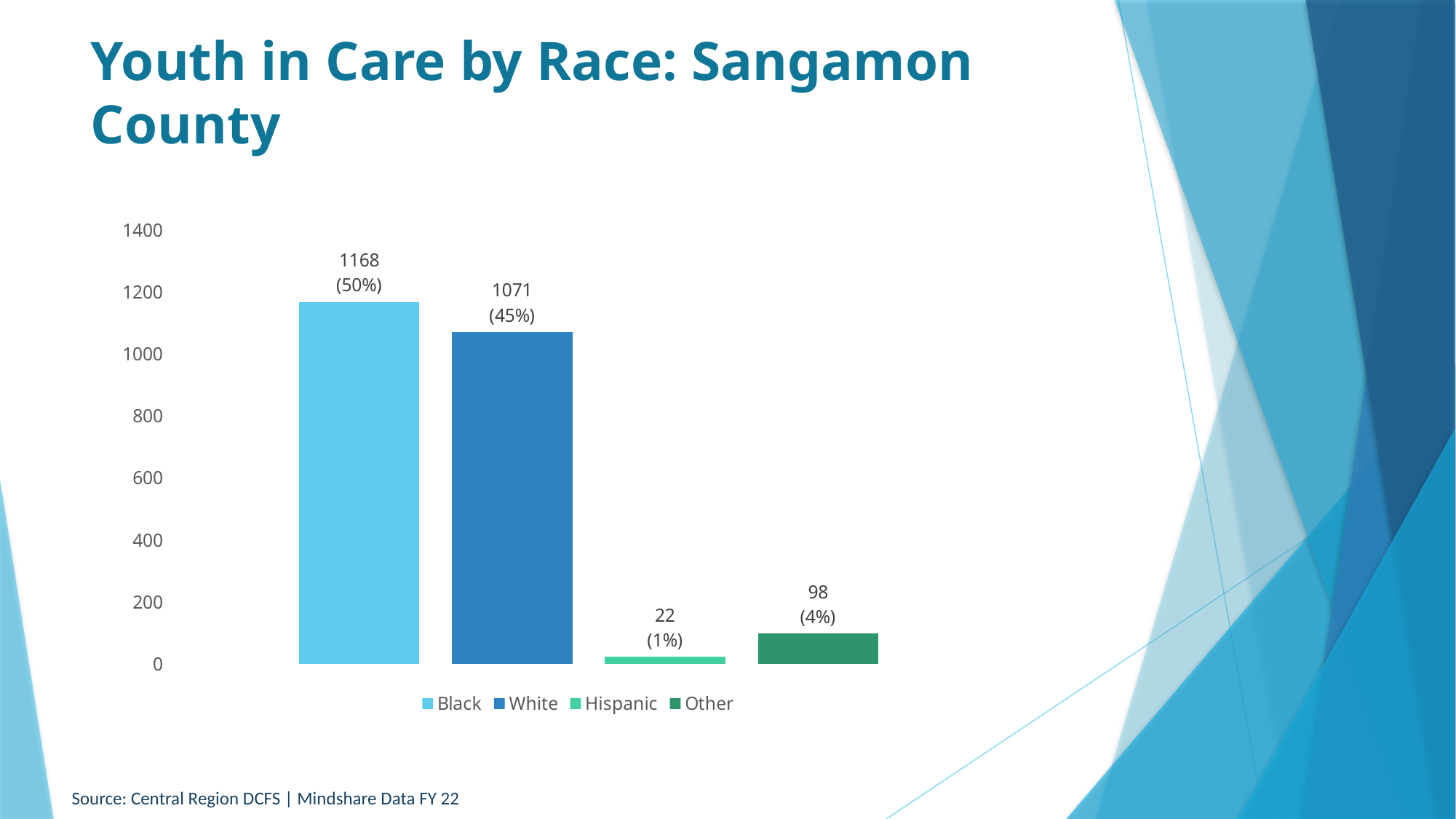
Is the value for White greater or less than 1000? greater What percentage of youth in care is shown for the Other category? 4% What kind of chart is shown on the slide? Bar chart What is the number of youth in care for White youth? 1071 What is the source cited for the chart data? Central Region DCFS | Mindshare Data FY 22 What is the difference between the number of Black youth and White youth in care? 97 How many race categories are shown in the chart? 4 Which is larger, the value for Other or the value for Hispanic? Other What is the number of youth in care for Black youth? 1168 Which race category has the lowest number of youth in care? Hispanic What is the number of youth in care for Hispanic youth? 22 Which race category has the highest number of youth in care? Black